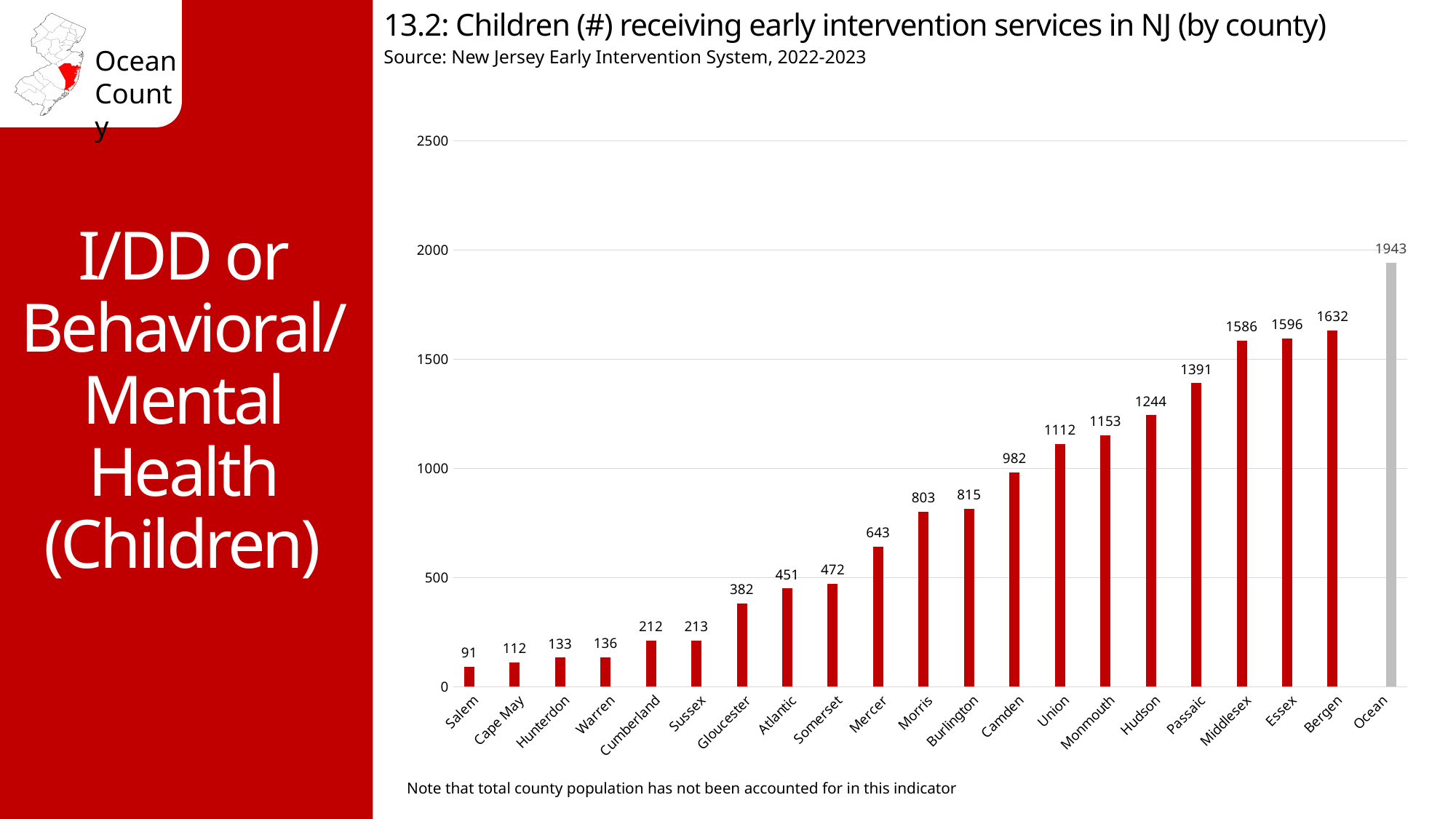
What kind of chart is shown on the slide? Bar chart What is the difference between the values for Camden and Burlington? 167 What is the value shown for Mercer County? 643 Which county has the highest number of children receiving early intervention services? Ocean How many counties are shown on the chart? 21 Is the value for Union County greater or less than 1000? greater What is the difference between the values for Ocean and Bergen? 311 Which county's bar is shown in grey rather than red? Ocean Which county has a larger value, Passaic or Monmouth? Passaic Which county has the lowest number of children receiving early intervention services? Salem How many children are receiving early intervention services in Ocean County? 1943 What is the value shown for Hudson County? 1244